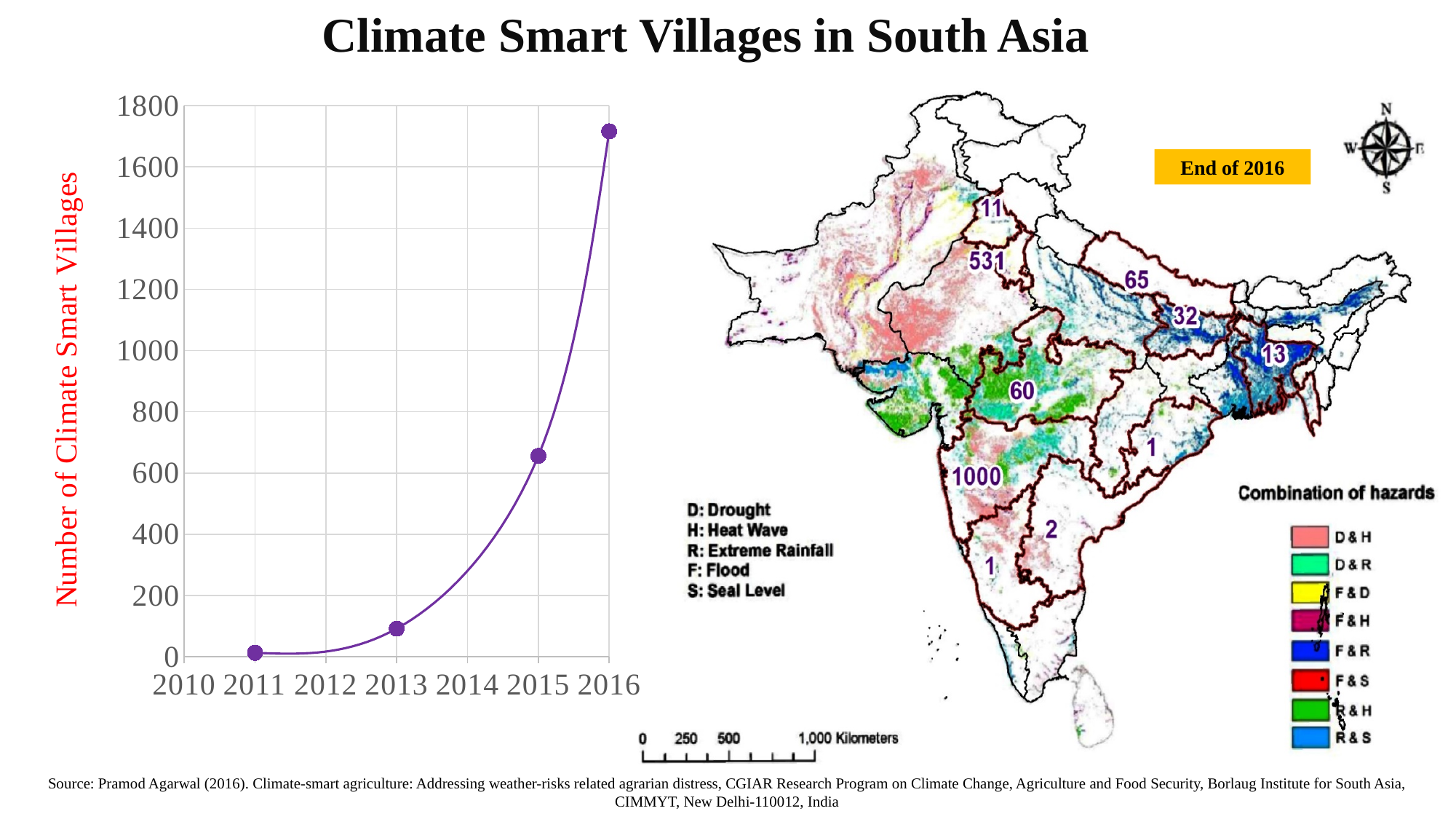
Is the number of Climate Smart Villages in 2015 greater or less than 600? greater Does the number of Climate Smart Villages rise or fall from 2011 to 2016 on the line chart? rise Is the number of Climate Smart Villages in 2015 greater or less than 800? less Which year has more Climate Smart Villages on the line chart, 2013 or 2015? 2015 Is the number of Climate Smart Villages in 2013 greater or less than 200? less Which year has the highest number of Climate Smart Villages on the line chart? 2016 What kind of chart is shown on the left of the slide? line chart How many data points are plotted on the line chart? 4 What is the highest value shown on the y axis of the line chart? 1800 Which year has the lowest number of Climate Smart Villages on the line chart? 2011 What is the label of the y axis on the line chart? Number of Climate Smart Villages